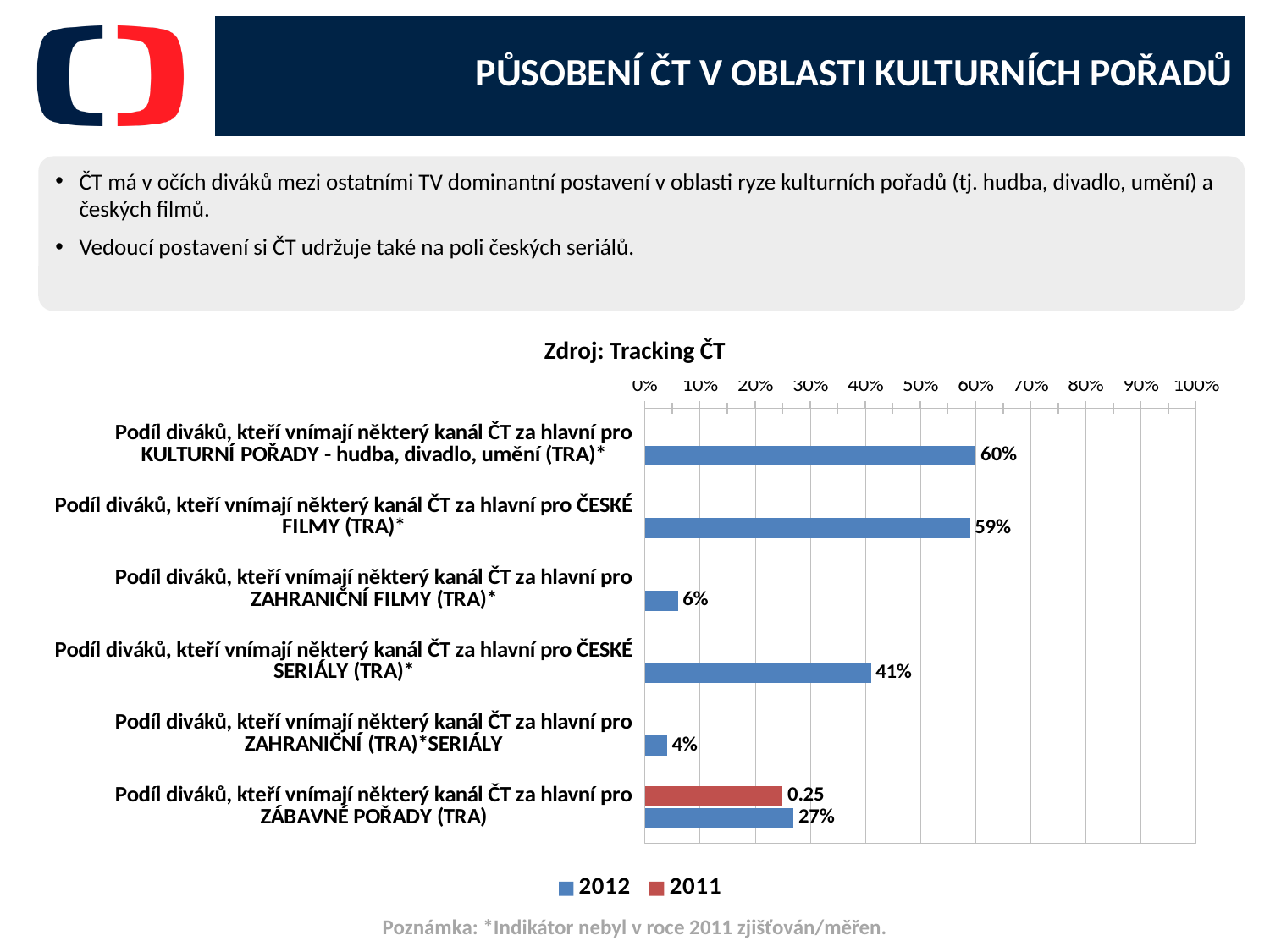
What is the 2012 value for ZAHRANIČNÍ FILMY? 6% What is the 2012 value for ČESKÉ SERIÁLY? 41% What is the 2012 value for the share of viewers who see a ČT channel as the main one for KULTURNÍ POŘADY - hudba, divadlo, umění? 60% Which has a larger 2012 value, ČESKÉ SERIÁLY or ZAHRANIČNÍ FILMY? ČESKÉ SERIÁLY What is the 2012 value for ČESKÉ FILMY? 59% What kind of chart is shown on the slide? Bar chart Which category has the highest 2012 value? KULTURNÍ POŘADY - hudba, divadlo, umění Which category has the lowest 2012 value? ZAHRANIČNÍ SERIÁLY What is the difference between the 2012 values for ČESKÉ SERIÁLY and ZÁBAVNÉ POŘADY? 14% How many categories are shown on the chart? 6 How many series does the legend list? 2 What is the 2011 value shown for ZÁBAVNÉ POŘADY? 0.25